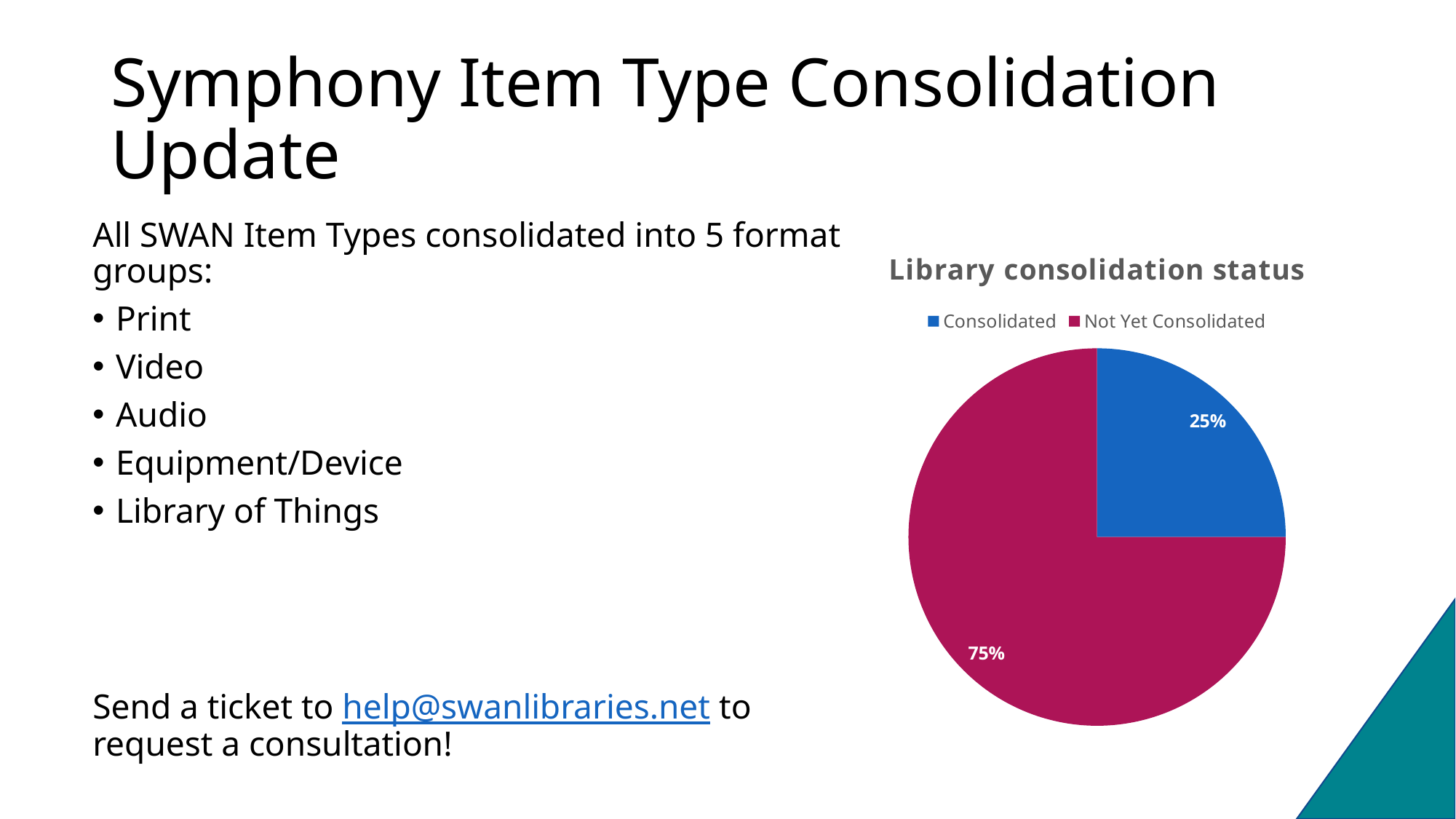
Which slice of the pie is the smallest? Consolidated What type of chart is shown on the slide? pie chart What share of the pie is labelled Not Yet Consolidated? 75% What share of the pie is labelled Consolidated? 25% Which is larger, the Consolidated slice or the Not Yet Consolidated slice? Not Yet Consolidated Which slice of the pie is the largest? Not Yet Consolidated How many entries does the chart legend list? 2 What colour is the Consolidated slice? blue How many slices does the pie chart have? 2 What is the title of the chart? Library consolidation status What is the difference in percentage points between the Not Yet Consolidated slice and the Consolidated slice? 50